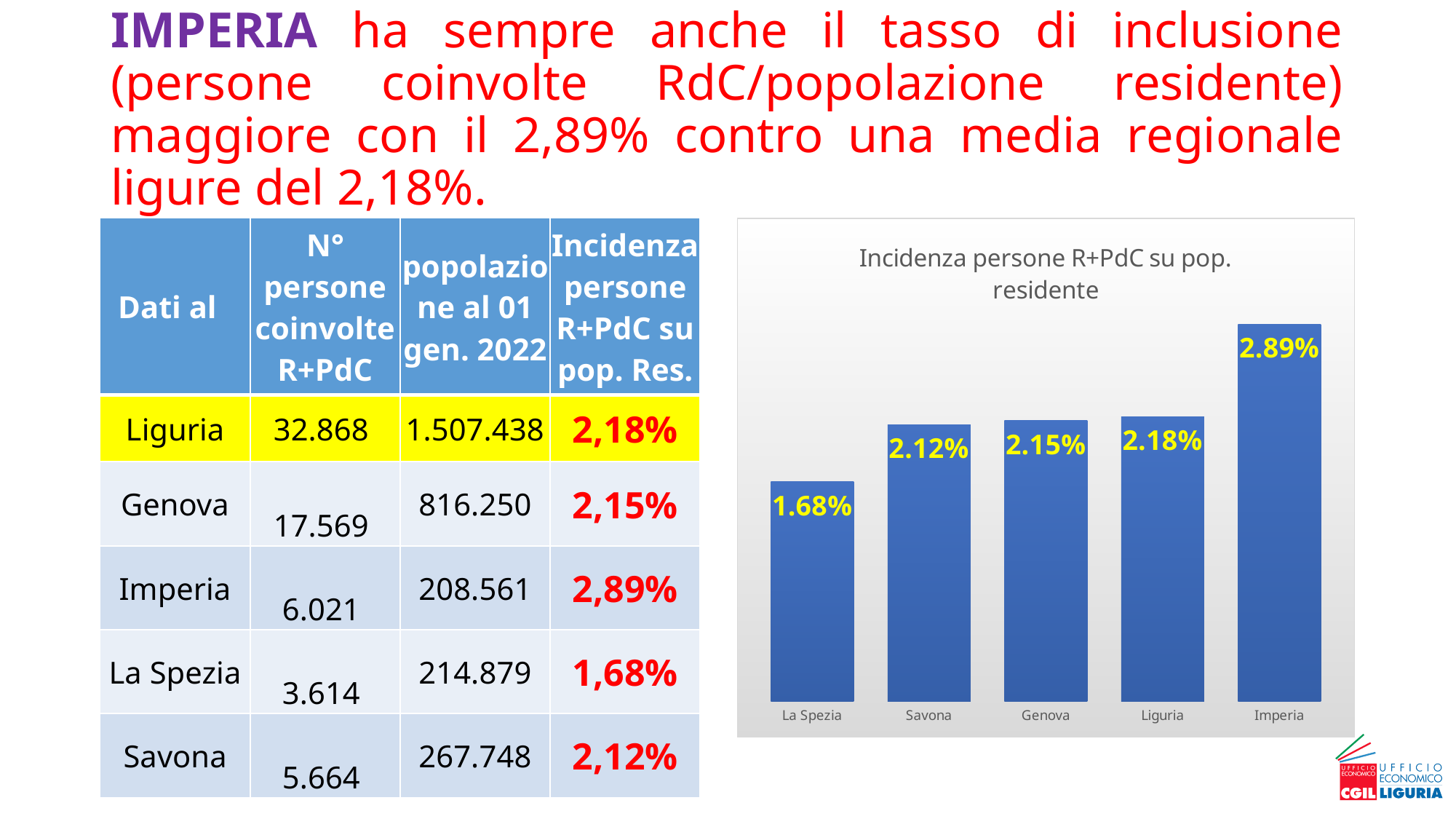
What is the difference between the values for Imperia and Liguria in the chart? 0.71% What is the value for La Spezia in the chart? 1.68% What is the value for Liguria in the chart? 2.18% How many categories are shown in the chart? 5 What is the value for Imperia in the chart? 2.89% What is the value for Savona in the chart? 2.12% Which is larger in the chart, the value for Imperia or the value for Genova? Imperia Which category has the highest value in the chart? Imperia What kind of chart is shown on the slide? Bar chart What is the difference between the values for Genova and La Spezia in the chart? 0.47% What is the title of the chart? Incidenza persone R+PdC su pop. residente Which category has the lowest value in the chart? La Spezia